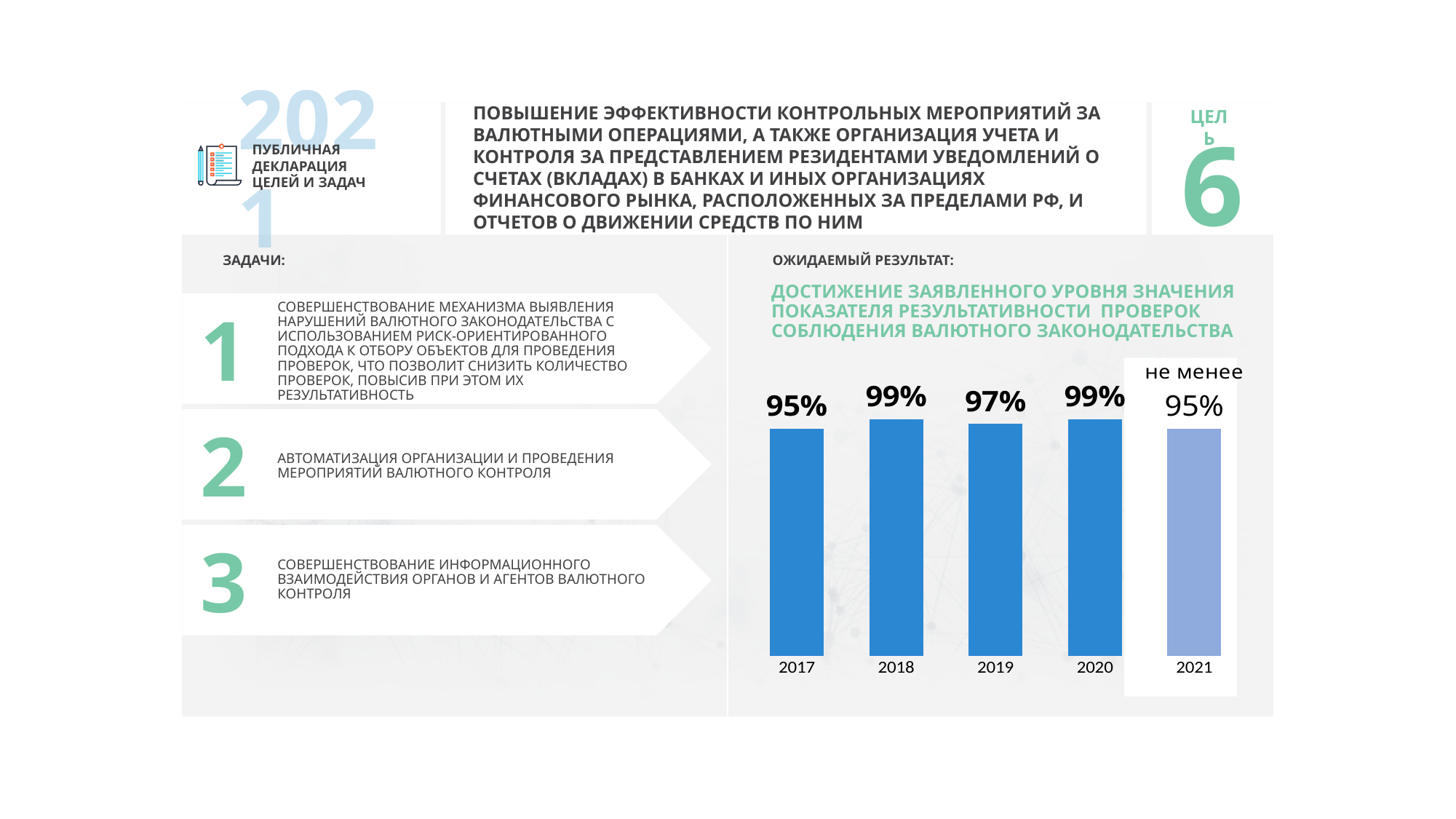
Which two years share the highest value in the bar chart? 2018 and 2020 What is the value shown for 2018 in the bar chart? 99% What kind of chart is shown on the slide? bar chart Which bar in the chart is drawn in a lighter blue colour than the others? 2021 Which is larger in the bar chart, the value for 2019 or the value for 2020? 2020 How many bars are shown in the chart? 5 What is the value shown for 2020 in the bar chart? 99% By how many percentage points does the 2018 value exceed the 2017 value? 4 Among the years 2017 to 2020, which year has the lowest value in the bar chart? 2017 What is the value shown for 2019 in the bar chart? 97% What is the value shown for 2017 in the bar chart? 95% What label is shown above the 2021 bar in the chart? не менее 95%